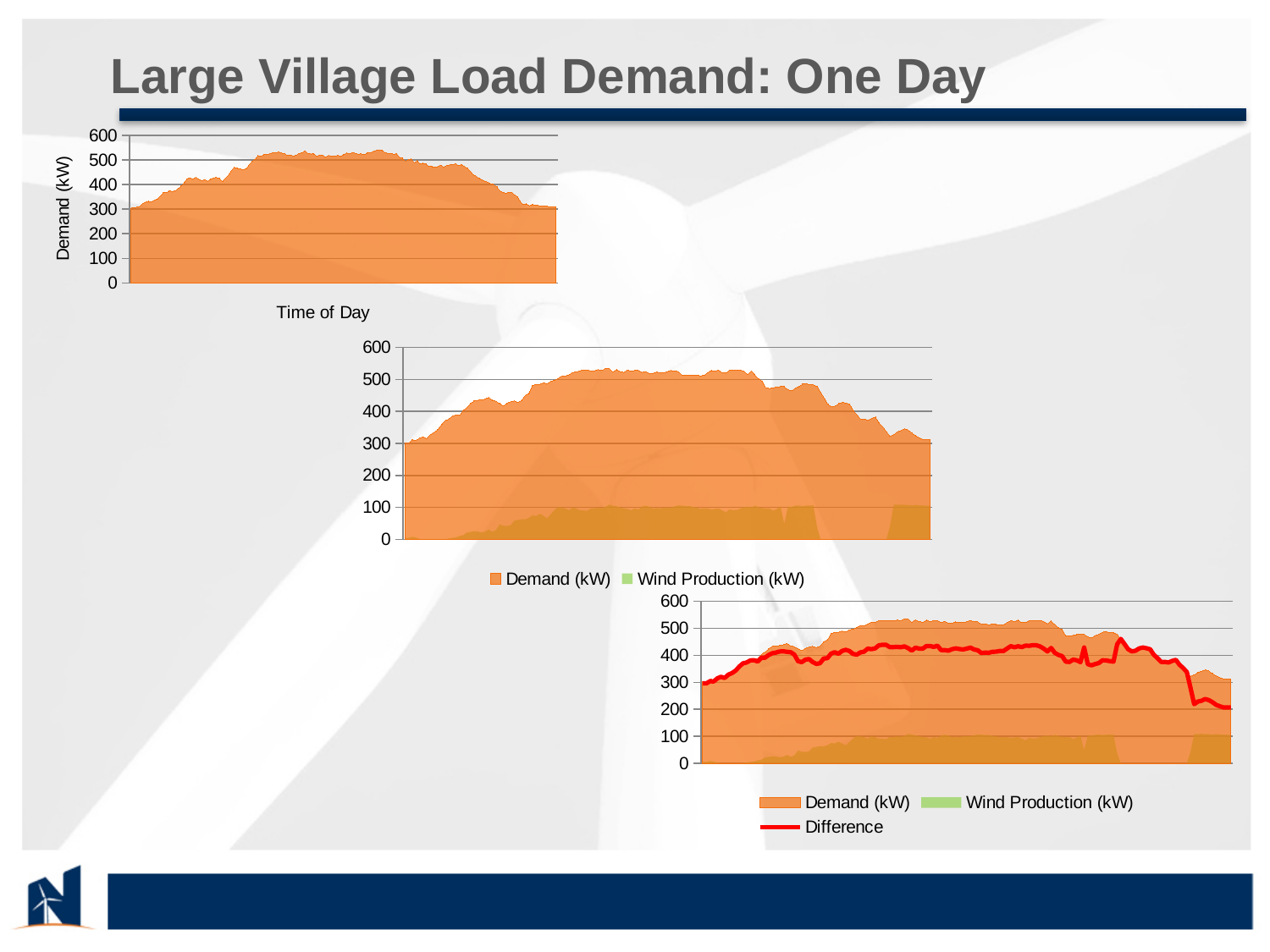
What kind of chart is the top-left chart on the slide? area chart What is the x-axis title of the top-left chart? Time of Day What is the y-axis title of the top-left chart? Demand (kW) How many series does the legend of the middle chart list? 2 In the middle chart, is the highest Wind Production (kW) value greater or less than 200? less In the middle chart, is the peak Demand (kW) value greater or less than 500? greater How many series does the legend of the bottom-right chart list? 3 In the top-left chart, is the peak demand value greater or less than 500? greater What is the highest value shown on the y-axis of the bottom-right chart? 600 In the bottom-right chart, is the Difference line higher at the start of the day or at the end of the day? start of the day